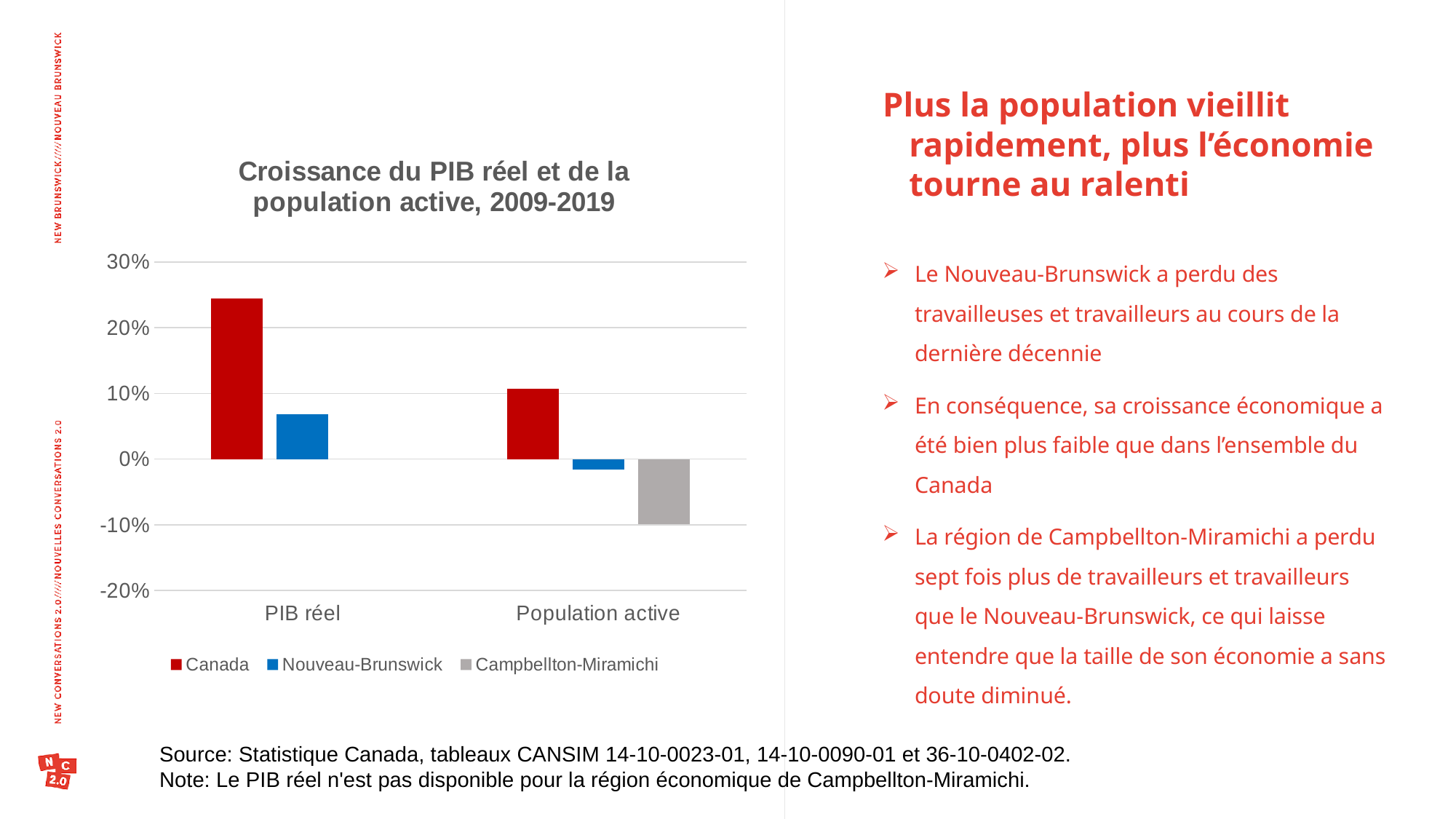
What is the title of the chart? Croissance du PIB réel et de la population active, 2009-2019 What kind of chart is shown on the slide? bar chart Is the value for Nouveau-Brunswick in Population active greater or less than 0%? less For Canada, which category has the larger value: PIB réel or Population active? PIB réel Which series is shown in red in the chart? Canada Which series has the highest value for PIB réel? Canada How many series does the chart legend list? 3 How many categories are shown on the x axis of the chart? 2 For PIB réel, which is larger: the value for Canada or the value for Nouveau-Brunswick? Canada Is the value for Nouveau-Brunswick in PIB réel greater or less than 10%? less Is the value for Canada in PIB réel greater or less than 20%? greater Which series has the lowest value for Population active? Campbellton-Miramichi